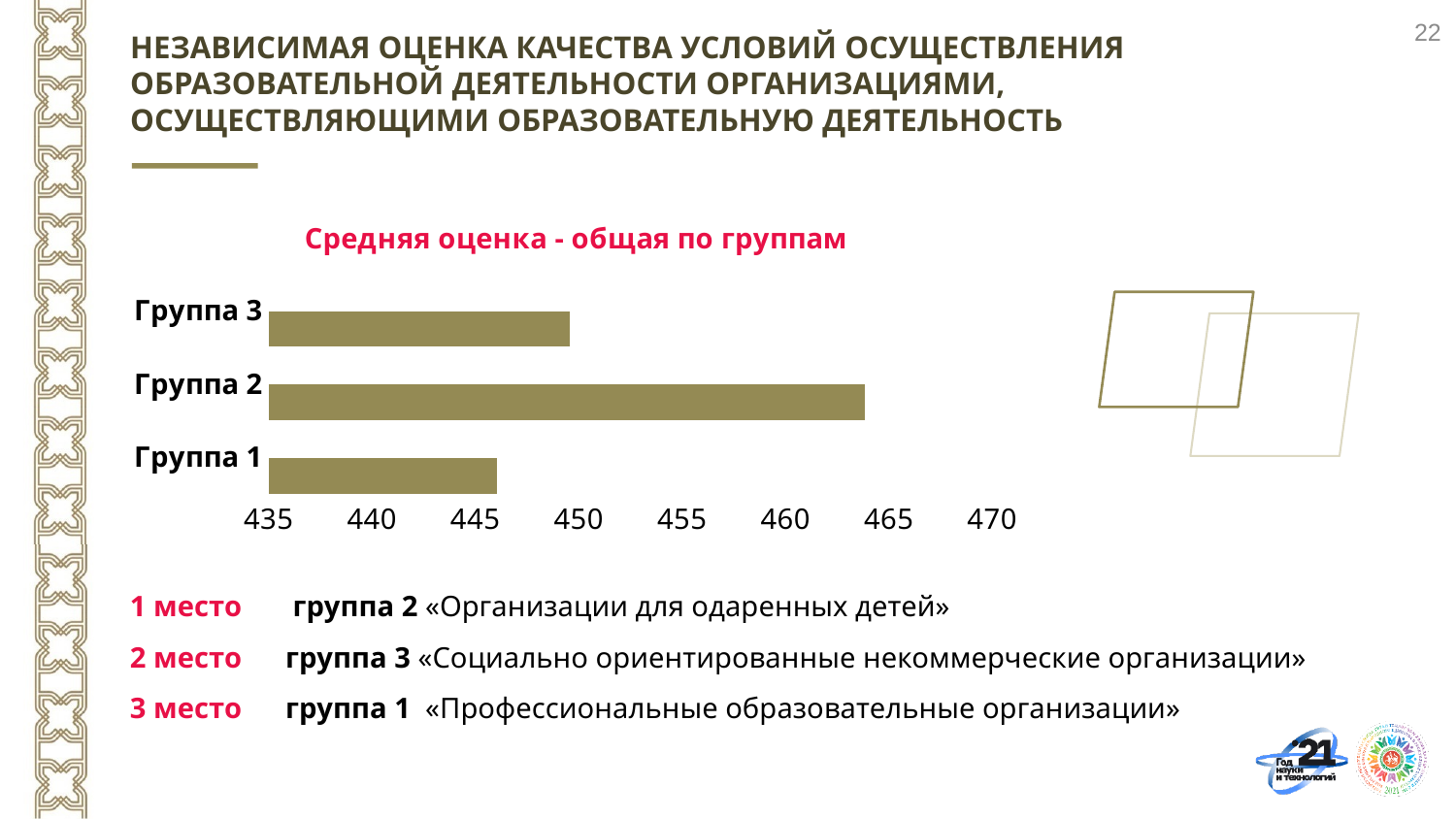
What is the lowest value shown on the horizontal axis of the chart? 435 What is the title of the chart? Средняя оценка - общая по группам How many groups (categories) are plotted in the chart? 3 Is the value for Группа 1 greater or less than 450? less Which group has the lowest average score in the chart? Группа 1 Is the value for Группа 3 greater or less than 455? less What kind of chart is shown on the slide? bar chart Which has a higher value in the chart, Группа 2 or Группа 3? Группа 2 Which group has the highest average score in the chart? Группа 2 Is the value for Группа 2 greater or less than 470? less Which has a higher value in the chart, Группа 3 or Группа 1? Группа 3